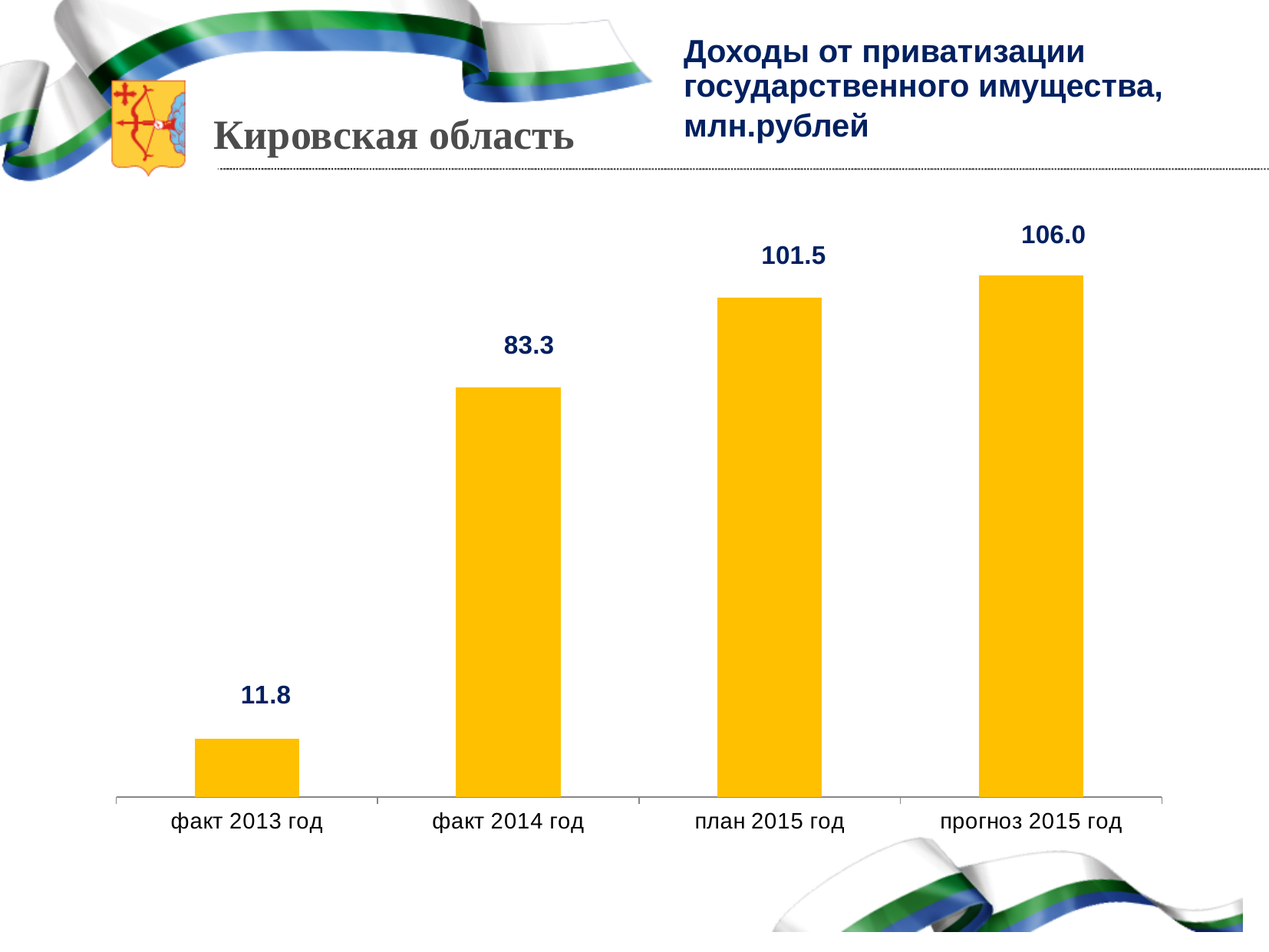
What is the difference between the values for факт 2014 год and факт 2013 год? 71.5 What is the value for факт 2014 год? 83.3 What is the value for факт 2013 год? 11.8 What is the difference between the values for прогноз 2015 год and план 2015 год? 4.5 Do the values rise or fall from left to right along the x axis? rise Which category has the lowest value? факт 2013 год What is the value for план 2015 год? 101.5 How many categories are shown on the x axis? 4 Which category has the highest value? прогноз 2015 год What is the value for прогноз 2015 год? 106.0 What kind of chart is shown on the slide? bar chart Which is larger, the value for план 2015 год or the value for факт 2014 год? план 2015 год